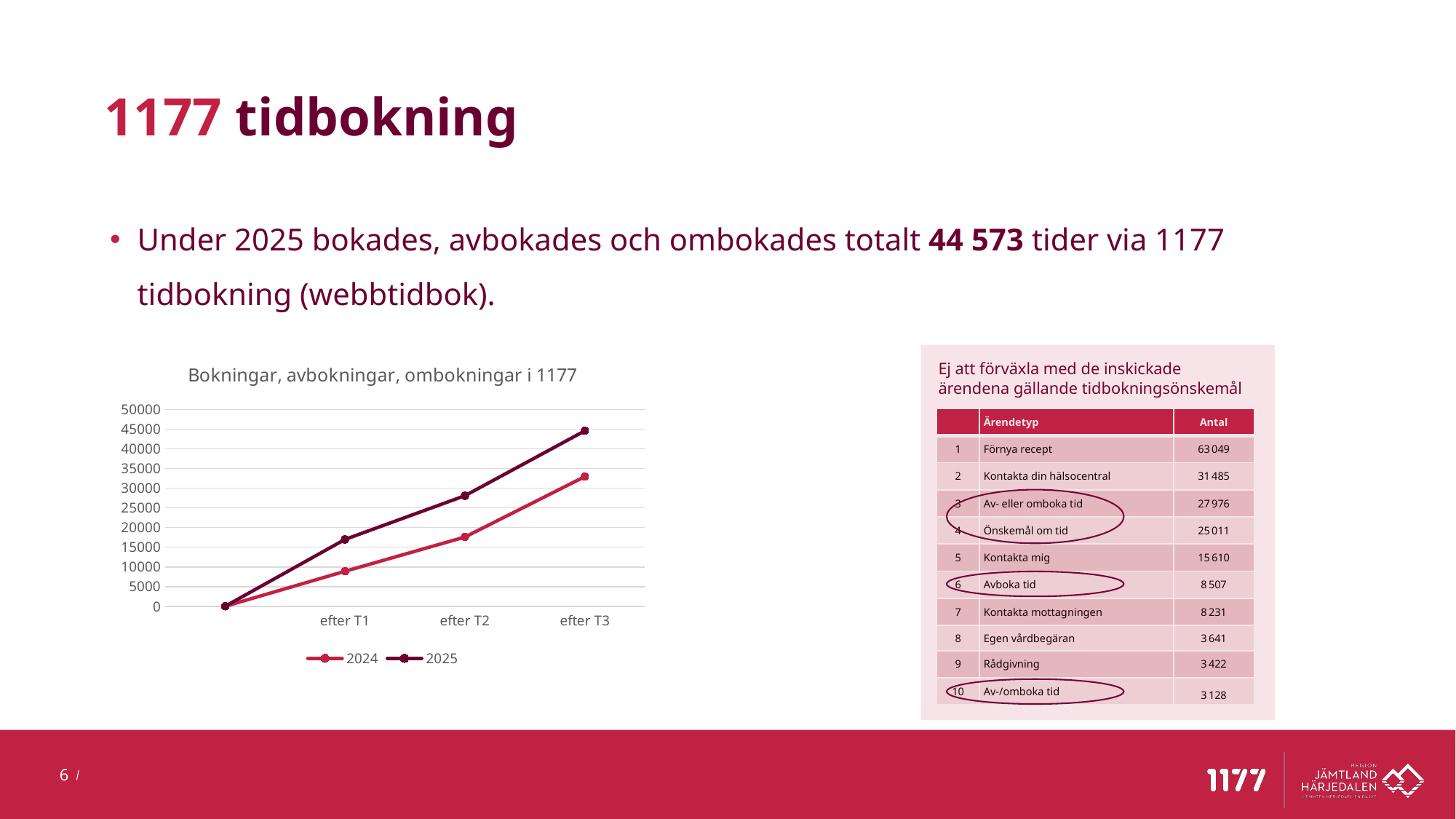
Is the 2025 value at 'efter T2' greater or less than 25000? greater Is the 2024 value at 'efter T2' greater or less than 20000? less Is the 2025 value at 'efter T1' greater or less than 15000? greater At 'efter T2', which series has the higher value, 2024 or 2025? 2025 What are the two series named in the chart legend? 2024 and 2025 Do the values for the 2025 series rise or fall from left to right along the x axis? rise How many series does the chart legend list? 2 What type of chart is shown on the slide? line chart What is the title of the chart? Bokningar, avbokningar, ombokningar i 1177